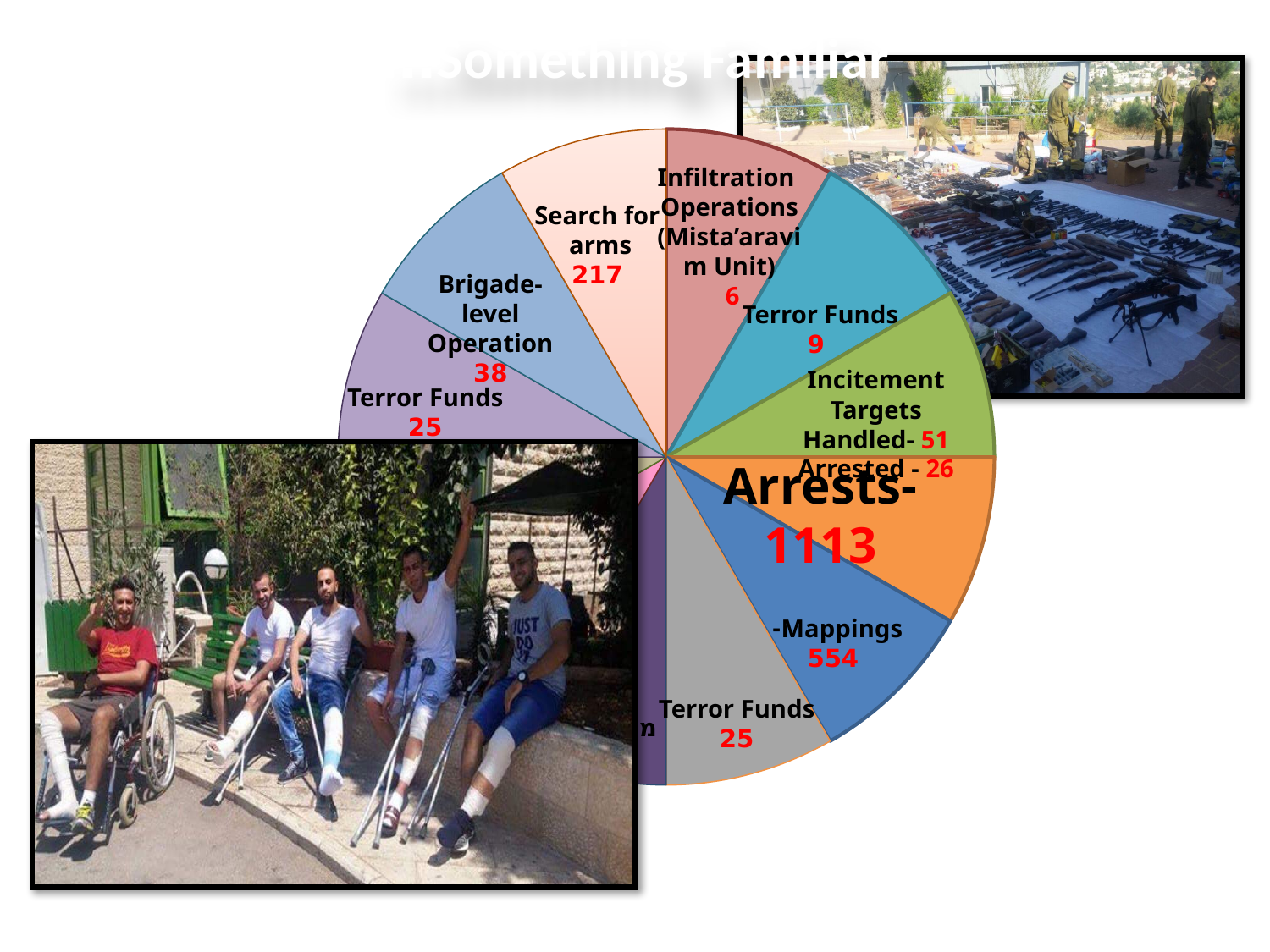
What kind of chart is shown on the slide? pie chart What is the value shown for Search for arms? 217 How many Incitement Targets were Handled according to the chart? 51 Which labelled category has the highest value in the chart? Arrests What is the value shown for Arrests? 1113 What is the difference between the values for Search for arms and Brigade-level Operation? 179 What is the value shown for Mappings? 554 What is the difference between the values for Arrests and Mappings? 559 Which has the larger value, Mappings or Search for arms? Mappings What is the value shown for Infiltration Operations (Mista'aravim Unit)? 6 What is the value shown for Brigade-level Operation? 38 How many were Arrested in the Incitement Targets slice? 26